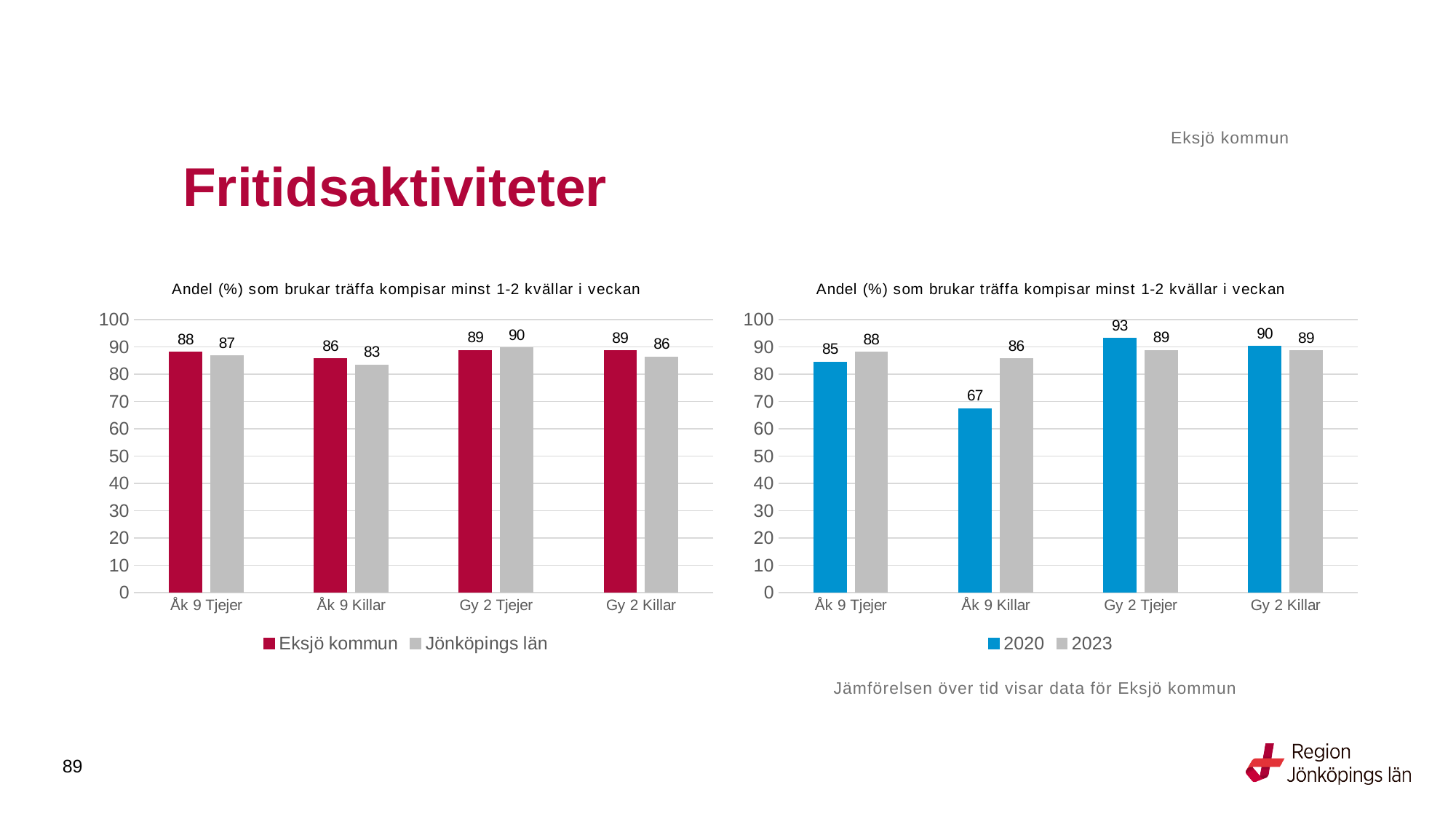
In the left chart, which is larger for Gy 2 Killar: Eksjö kommun or Jönköpings län? Eksjö kommun In the left chart, what is the value for Eksjö kommun for Åk 9 Killar? 86 In the left chart, what is the value for Jönköpings län for Gy 2 Tjejer? 90 In the right chart, what is the value for 2020 for Åk 9 Killar? 67 In the right chart, what is the value for 2023 for Gy 2 Tjejer? 89 What kind of chart is the right chart? Bar chart How many series does the legend of the right chart list? 2 In the left chart, what is the difference between Eksjö kommun and Jönköpings län for Åk 9 Killar? 3 How many categories are shown on the x axis of the left chart? 4 In the right chart, what is the difference between the 2023 and 2020 values for Åk 9 Killar? 19 In the right chart, which category has the highest value for 2020? Gy 2 Tjejer In the right chart, which category has the lowest value for 2020? Åk 9 Killar